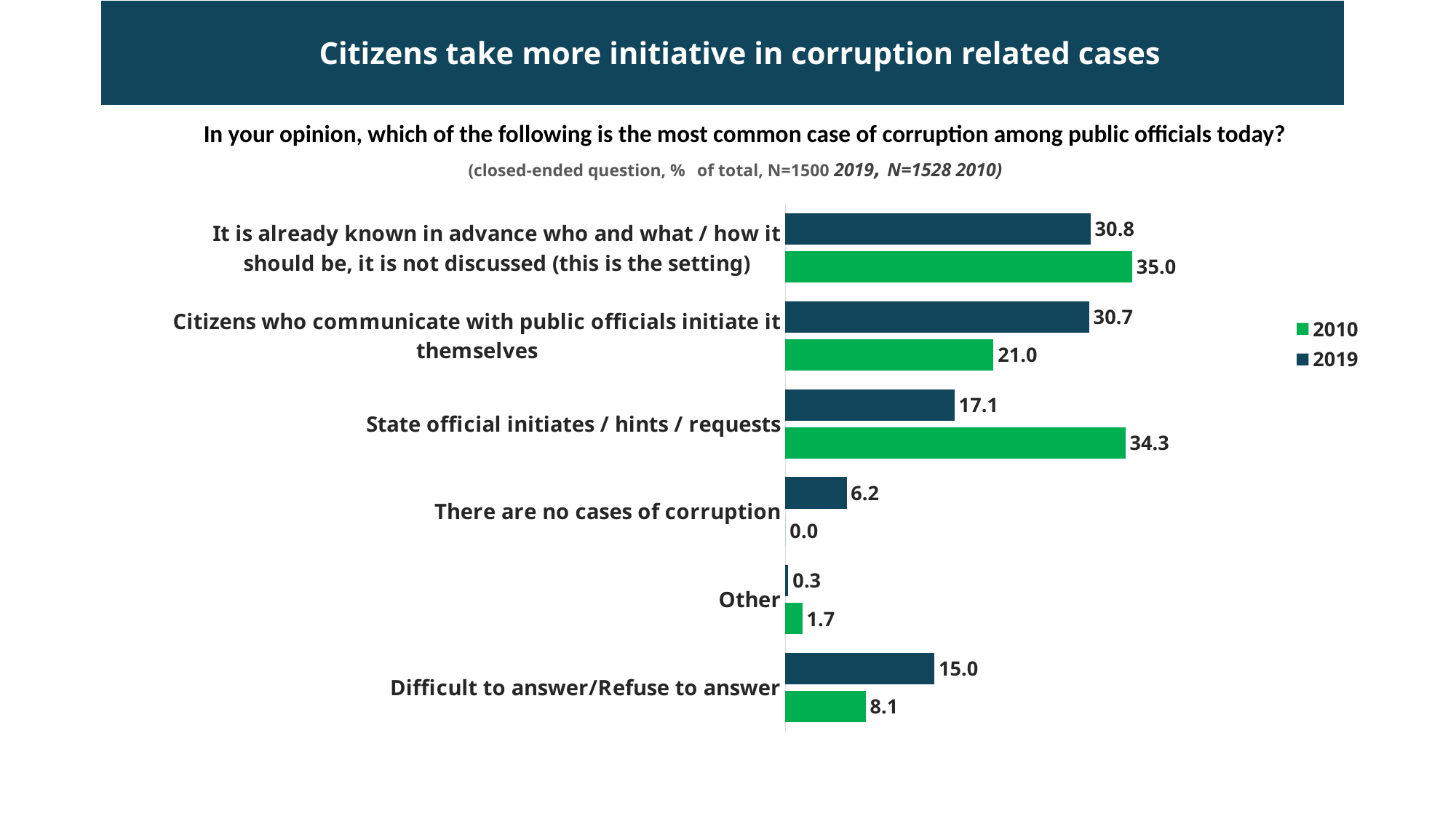
Which colour represents the 2010 series in the legend? green What is the 2010 value for 'State official initiates / hints / requests'? 34.3 Which category has the lowest 2019 value? Other What is the difference between the 2010 and 2019 values for 'State official initiates / hints / requests'? 17.2 Which category has the highest 2010 value? It is already known in advance who and what / how it should be, it is not discussed (this is the setting) What kind of chart is shown on the slide? bar chart How many series does the legend list? 2 For 'Difficult to answer/Refuse to answer', which year has the larger value, 2010 or 2019? 2019 What is the 2019 value for 'Citizens who communicate with public officials initiate it themselves'? 30.7 What is the 2010 value for 'There are no cases of corruption'? 0.0 What is the difference between the 2019 and 2010 values for 'Citizens who communicate with public officials initiate it themselves'? 9.7 How many categories are shown in the chart? 6